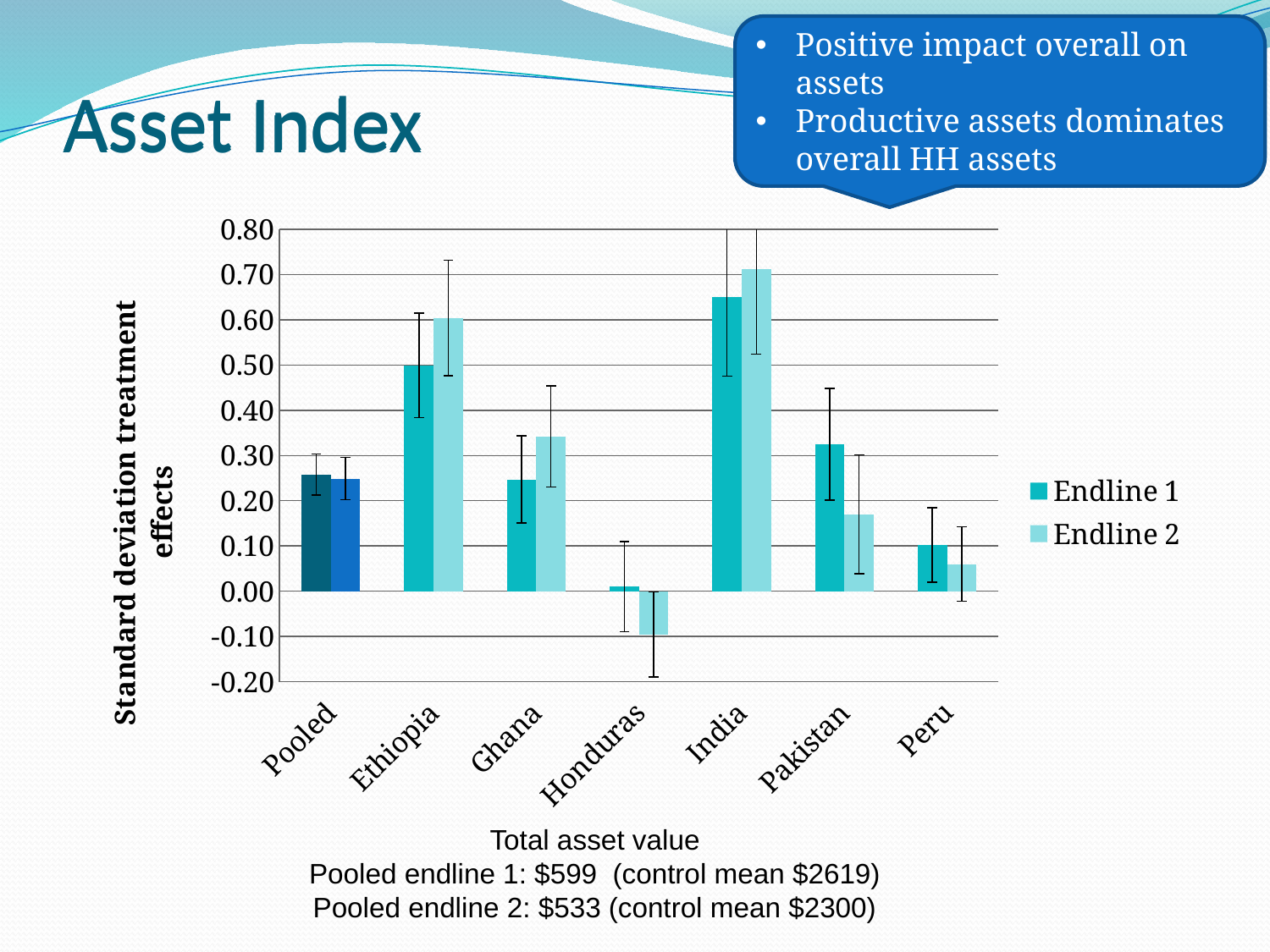
How many categories are shown on the x axis of the chart? 7 Which category has the highest Endline 1 value? India What kind of chart is shown on the slide? bar chart What is the title of the chart's vertical axis? Standard deviation treatment effects For Pakistan, which is larger: the Endline 1 value or the Endline 2 value? Endline 1 Which category has the lowest Endline 2 value? Honduras Which category has the highest Endline 2 value? India For Ethiopia, which is larger: the Endline 1 value or the Endline 2 value? Endline 2 Is the Endline 1 value for India greater or less than 0.60? greater Is the Endline 1 value for Peru greater or less than 0.20? less Is the Endline 2 value for Honduras greater or less than 0.00? less How many series does the chart's legend list? 2